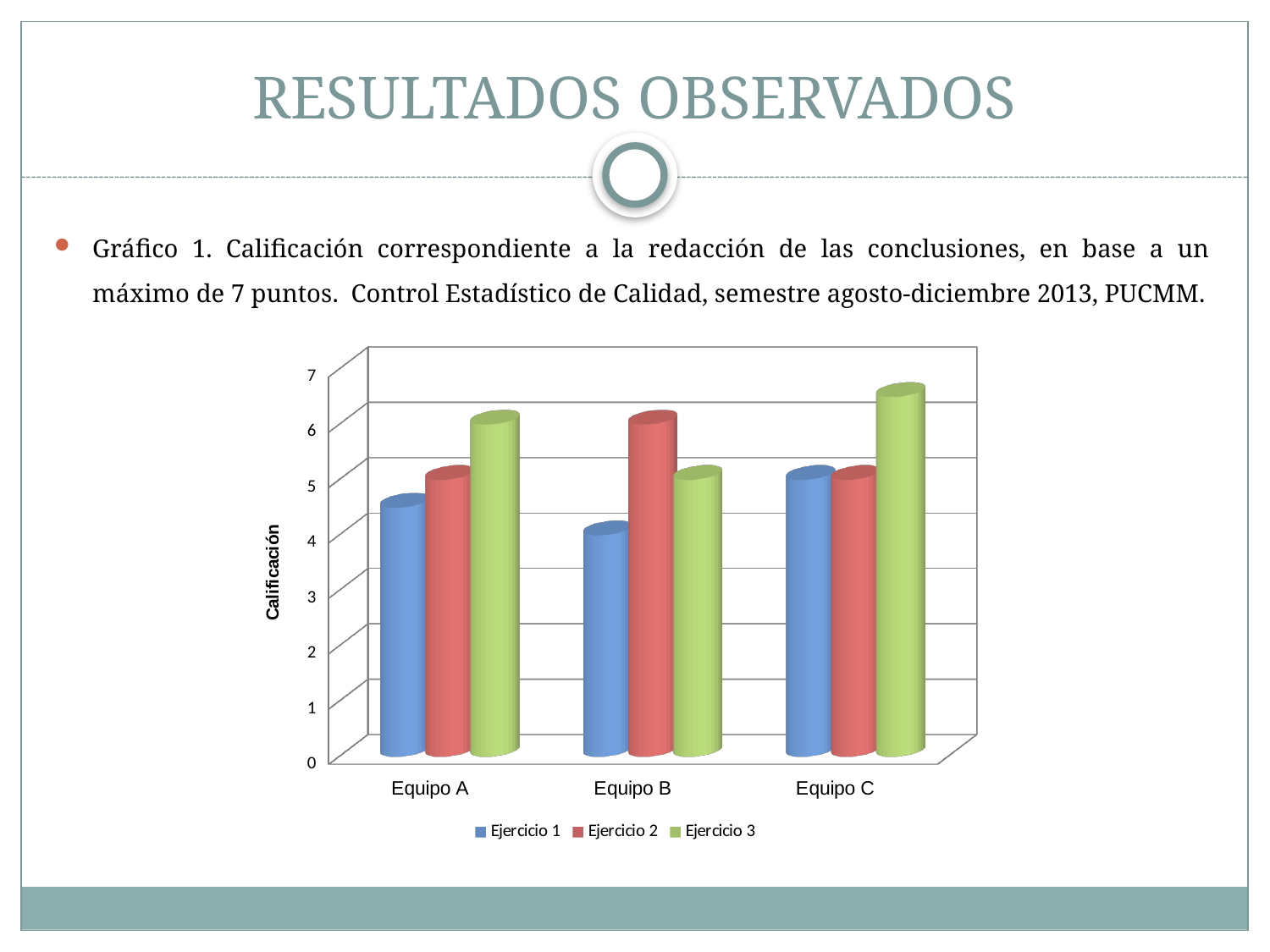
What is the title of the vertical axis of the chart? Calificación Which series has the highest value for Equipo B? Ejercicio 2 Is the value for Ejercicio 1 for Equipo B greater or less than 5? less What are the three series named in the chart's legend? Ejercicio 1, Ejercicio 2, Ejercicio 3 Is the value for Ejercicio 2 for Equipo B greater or less than 5? greater How many teams (categories) are shown on the x axis of the chart? 3 For Equipo B, which is larger: Ejercicio 1 or Ejercicio 2? Ejercicio 2 For Equipo A, which is larger: Ejercicio 1 or Ejercicio 3? Ejercicio 3 How many series does the chart's legend list? 3 Which series has the lowest value for Equipo B? Ejercicio 1 What kind of chart is shown on the slide? Bar chart Is the value for Ejercicio 3 for Equipo A greater or less than 5? greater